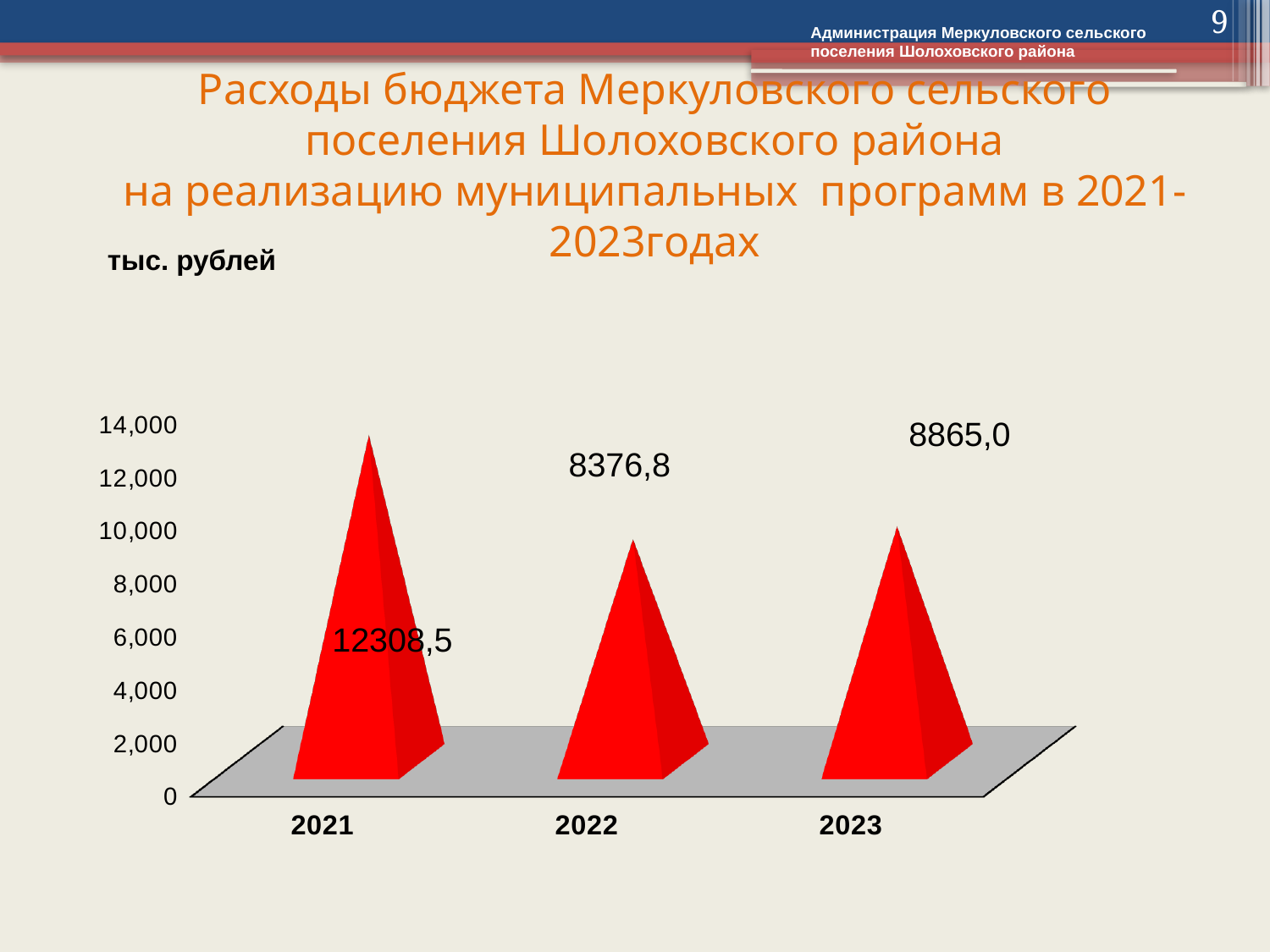
What is the value for 2023? 8865,0 What is the difference between the values for 2023 and 2022? 488,2 Is the value for 2022 greater or less than 10,000? less Which is larger, the value for 2021 or the value for 2023? 2021 What is the value for 2022? 8376,8 What is the value for 2021? 12308,5 How many years are shown on the x axis? 3 What kind of chart is shown on the slide? bar chart In what units are the values on the chart expressed, according to the label above the chart? тыс. рублей Which year has the highest value? 2021 Which year has the lowest value? 2022 What is the difference between the values for 2021 and 2022? 3931,7